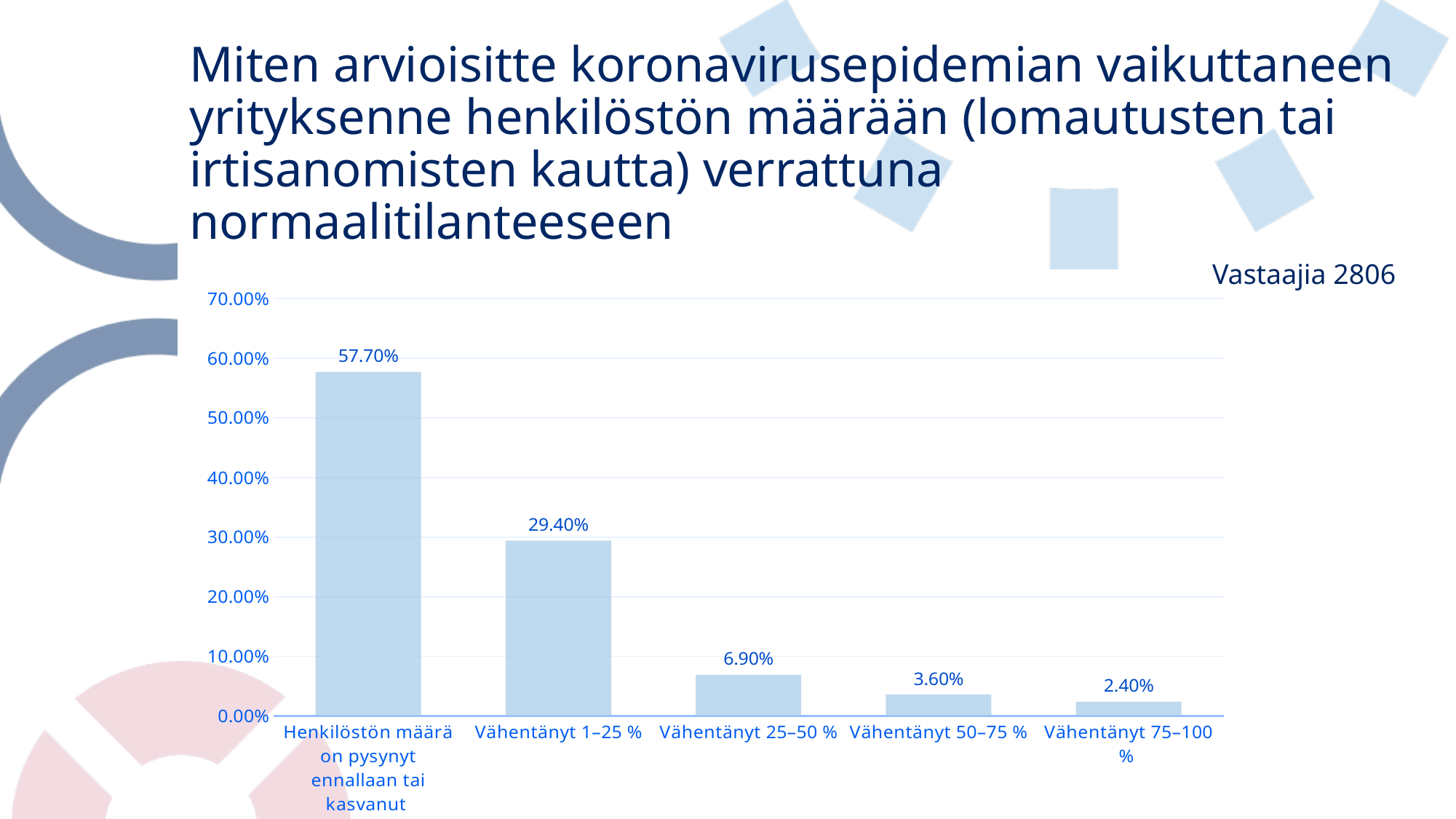
Which category has the highest value? Henkilöstön määrä on pysynyt ennallaan tai kasvanut What is the value for "Henkilöstön määrä on pysynyt ennallaan tai kasvanut"? 57.70% Which category has the lowest value? Vähentänyt 75–100 % What is the value for "Vähentänyt 25–50 %"? 6.90% How many categories are shown on the x axis? 5 What is the value for "Vähentänyt 1–25 %"? 29.40% Which is larger, the value for "Vähentänyt 50–75 %" or "Vähentänyt 75–100 %"? Vähentänyt 50–75 % What is the value for "Vähentänyt 75–100 %"? 2.40% What is the difference between the values for "Vähentänyt 1–25 %" and "Vähentänyt 25–50 %"? 22.50% Is the value for "Vähentänyt 1–25 %" greater or less than 30.00%? less What kind of chart is shown on the slide? bar chart How many respondents (Vastaajia) does the slide report? 2806